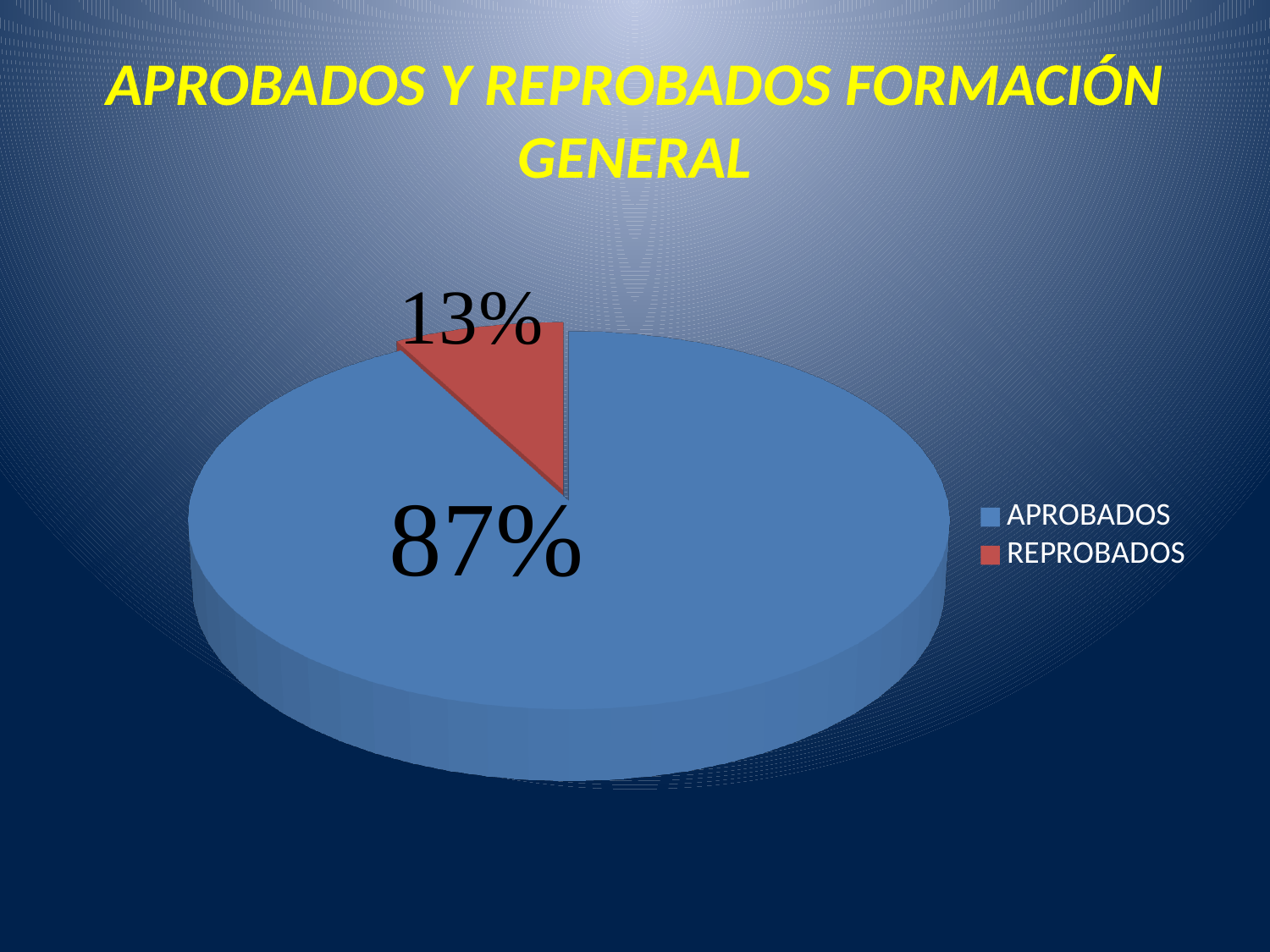
How many slices does the pie chart have? 2 What kind of chart is shown on the slide? Pie chart What colour is the REPROBADOS slice? Red What percentage of the pie is REPROBADOS? 13% Which category has the smallest share of the pie? REPROBADOS What percentage of the pie is APROBADOS? 87% How many entries does the legend list? 2 Which category has the largest share of the pie? APROBADOS What is the difference in percentage points between APROBADOS and REPROBADOS? 74 Which is larger, the share for APROBADOS or the share for REPROBADOS? APROBADOS What is the title of the chart? APROBADOS Y REPROBADOS FORMACIÓN GENERAL